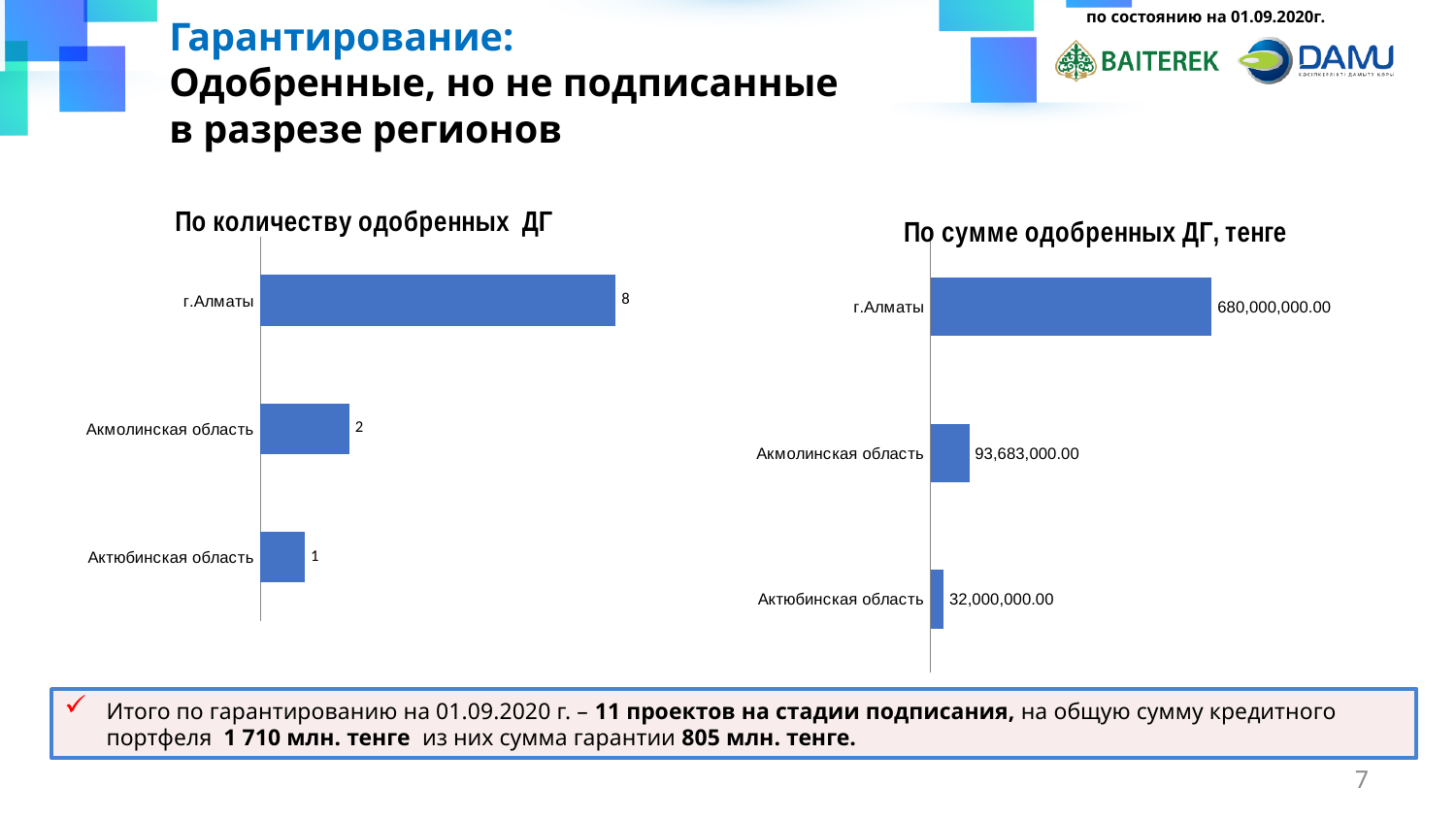
In the chart 'По количеству одобренных ДГ', which region has the lowest value? Актюбинская область In the chart 'По количеству одобренных ДГ', what is the value for г.Алматы? 8 What is the total of all values in the chart 'По количеству одобренных ДГ'? 11 In the chart 'По сумме одобренных ДГ, тенге', which region has the highest value? г.Алматы In the chart 'По сумме одобренных ДГ, тенге', which is larger: the value for Акмолинская область or Актюбинская область? Акмолинская область How many regions are shown in the chart 'По количеству одобренных ДГ'? 3 In the chart 'По количеству одобренных ДГ', what is the value for Акмолинская область? 2 In the chart 'По сумме одобренных ДГ, тенге', what is the value for Акмолинская область? 93,683,000.00 In the chart 'По сумме одобренных ДГ, тенге', what is the value for Актюбинская область? 32,000,000.00 In the chart 'По количеству одобренных ДГ', what is the difference between the values for г.Алматы and Акмолинская область? 6 In the chart 'По сумме одобренных ДГ, тенге', what is the difference between the values for г.Алматы and Актюбинская область? 648,000,000.00 What type of chart is 'По сумме одобренных ДГ, тенге'? Bar chart